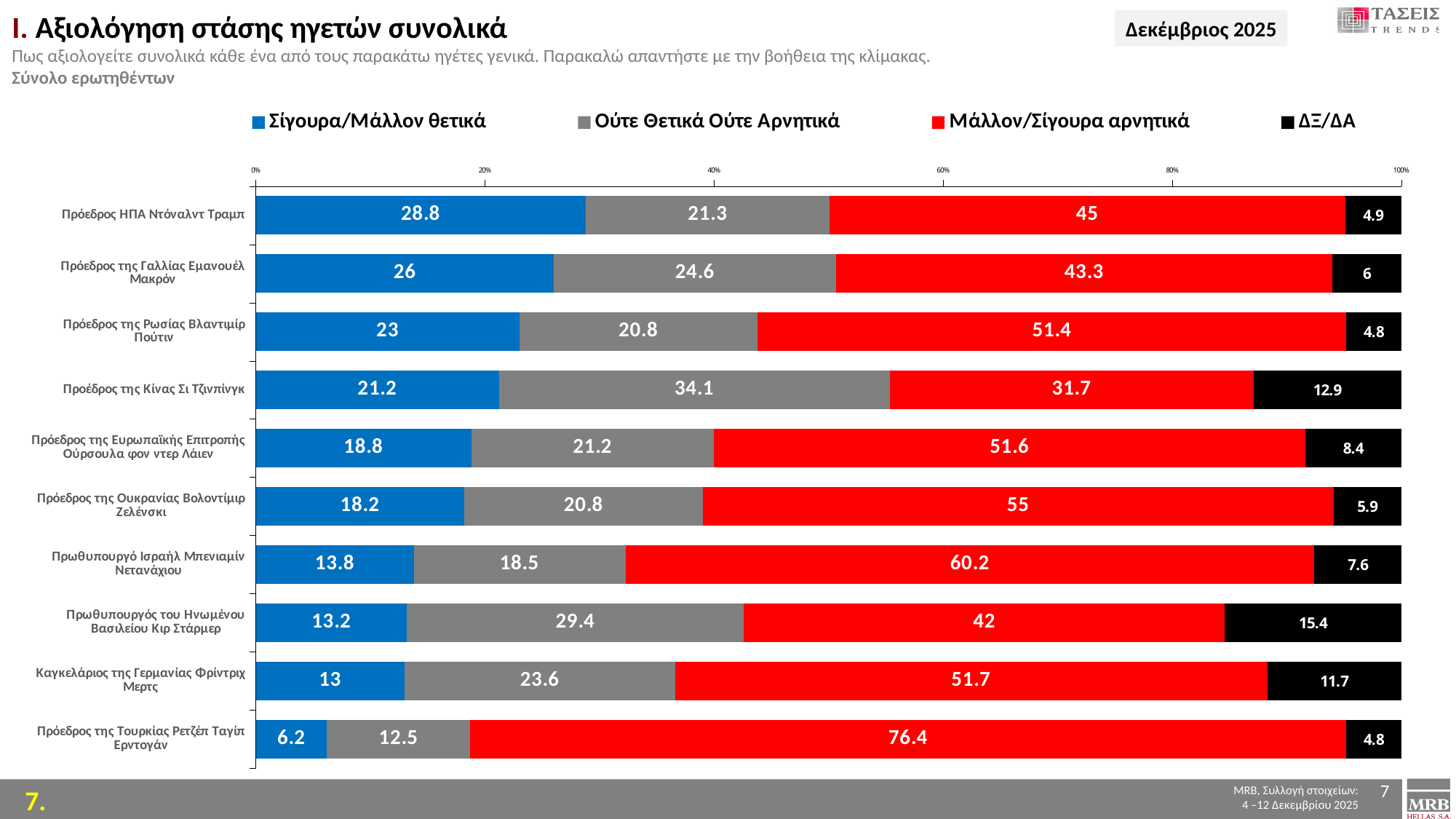
What kind of chart is shown on the slide? Stacked bar chart Who has the larger Σίγουρα/Μάλλον θετικά value, Πρόεδρος της Γαλλίας Εμανουέλ Μακρόν or Πρόεδρος της Ρωσίας Βλαντιμίρ Πούτιν? Πρόεδρος της Γαλλίας Εμανουέλ Μακρόν Which leader has the highest ΔΞ/ΔΑ value? Πρωθυπουργός του Ηνωμένου Βασιλείου Κιρ Στάρμερ What is the difference between the Μάλλον/Σίγουρα αρνητικά values for Πρωθυπουργό Ισραήλ Μπενιαμίν Νετανιάχου and Πρόεδρος της Ουκρανίας Βολοντίμιρ Ζελένσκι? 5.2 Which leader has the lowest Σίγουρα/Μάλλον θετικά value? Πρόεδρος της Τουρκίας Ρετζέπ Ταγίπ Ερντογάν What is the value of Μάλλον/Σίγουρα αρνητικά for Πρόεδρος της Τουρκίας Ρετζέπ Ταγίπ Ερντογάν? 76.4 What is the value of Σίγουρα/Μάλλον θετικά for Πρόεδρος ΗΠΑ Ντόναλντ Τραμπ? 28.8 Which leader has the highest Μάλλον/Σίγουρα αρνητικά value? Πρόεδρος της Τουρκίας Ρετζέπ Ταγίπ Ερντογάν What is the total of the stacked bar for Πρόεδρος ΗΠΑ Ντόναλντ Τραμπ? 100 How many leaders are shown in the chart? 10 Which leader has the highest Ούτε Θετικά Ούτε Αρνητικά value? Πρόεδρος της Κίνας Σι Τζινπίνγκ How many series does the legend list? 4